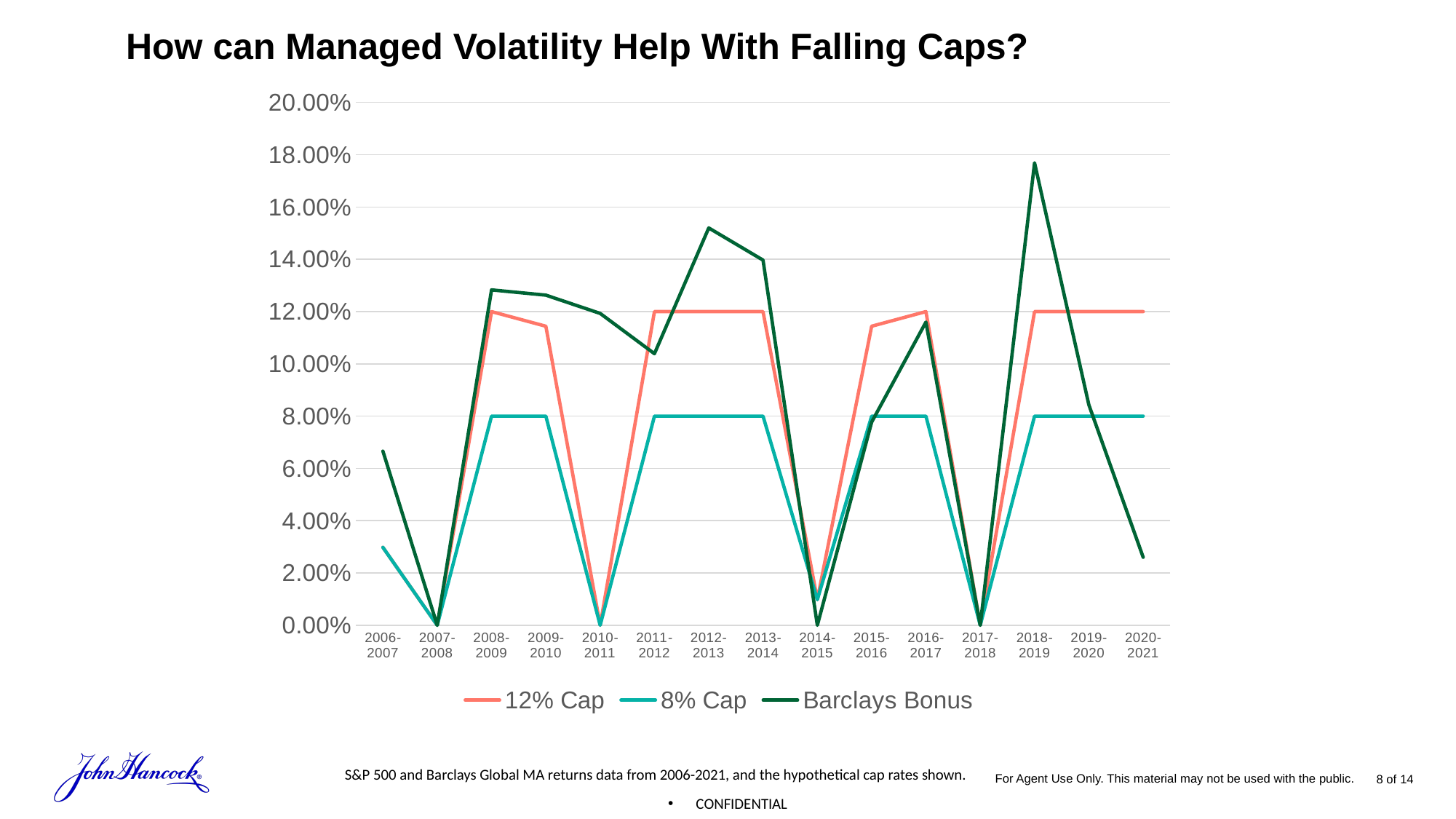
For 2019-2020, which is larger: the 12% Cap value or the Barclays Bonus value? 12% Cap Is the Barclays Bonus value for 2020-2021 greater or less than 4.00%? less In which period does the Barclays Bonus series reach its highest value? 2018-2019 What is the value of the 8% Cap series for 2012-2013? 8.00% How many periods are shown along the x axis? 15 Is the Barclays Bonus value for 2018-2019 greater or less than 16.00%? greater What is the value of the 12% Cap series for 2018-2019? 12.00% What is the value of the 12% Cap series for 2007-2008? 0.00% What type of chart is shown on the slide? line chart How many series does the legend list? 3 For 2012-2013, which is larger: the Barclays Bonus value or the 12% Cap value? Barclays Bonus Does the Barclays Bonus series rise or fall from 2018-2019 to 2020-2021? fall